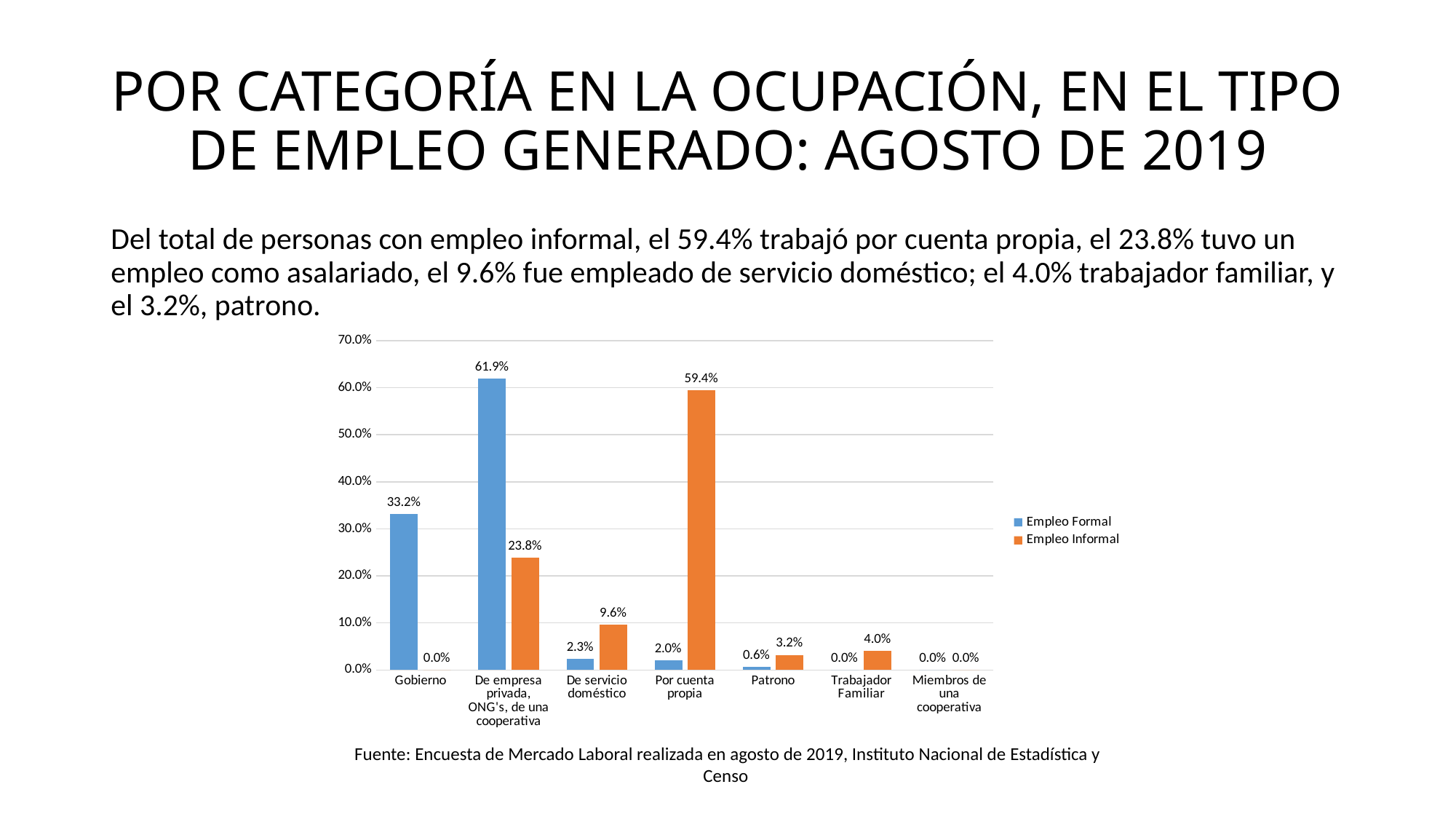
How many series does the legend list? 2 What is the Empleo Informal value for De servicio doméstico? 9.6% What kind of chart is shown on the slide? Bar chart Which category has the highest Empleo Informal value? Por cuenta propia Which is larger for Trabajador Familiar: Empleo Formal or Empleo Informal? Empleo Informal Which series is shown in orange in the legend? Empleo Informal What is the Empleo Informal value for Por cuenta propia? 59.4% What is the difference between the Empleo Formal and Empleo Informal values for De empresa privada, ONG's, de una cooperativa? 38.1% How many categories are shown on the x axis? 7 Which category has the highest Empleo Formal value? De empresa privada, ONG's, de una cooperativa What is the Empleo Formal value for Patrono? 0.6% What is the Empleo Formal value for Gobierno? 33.2%